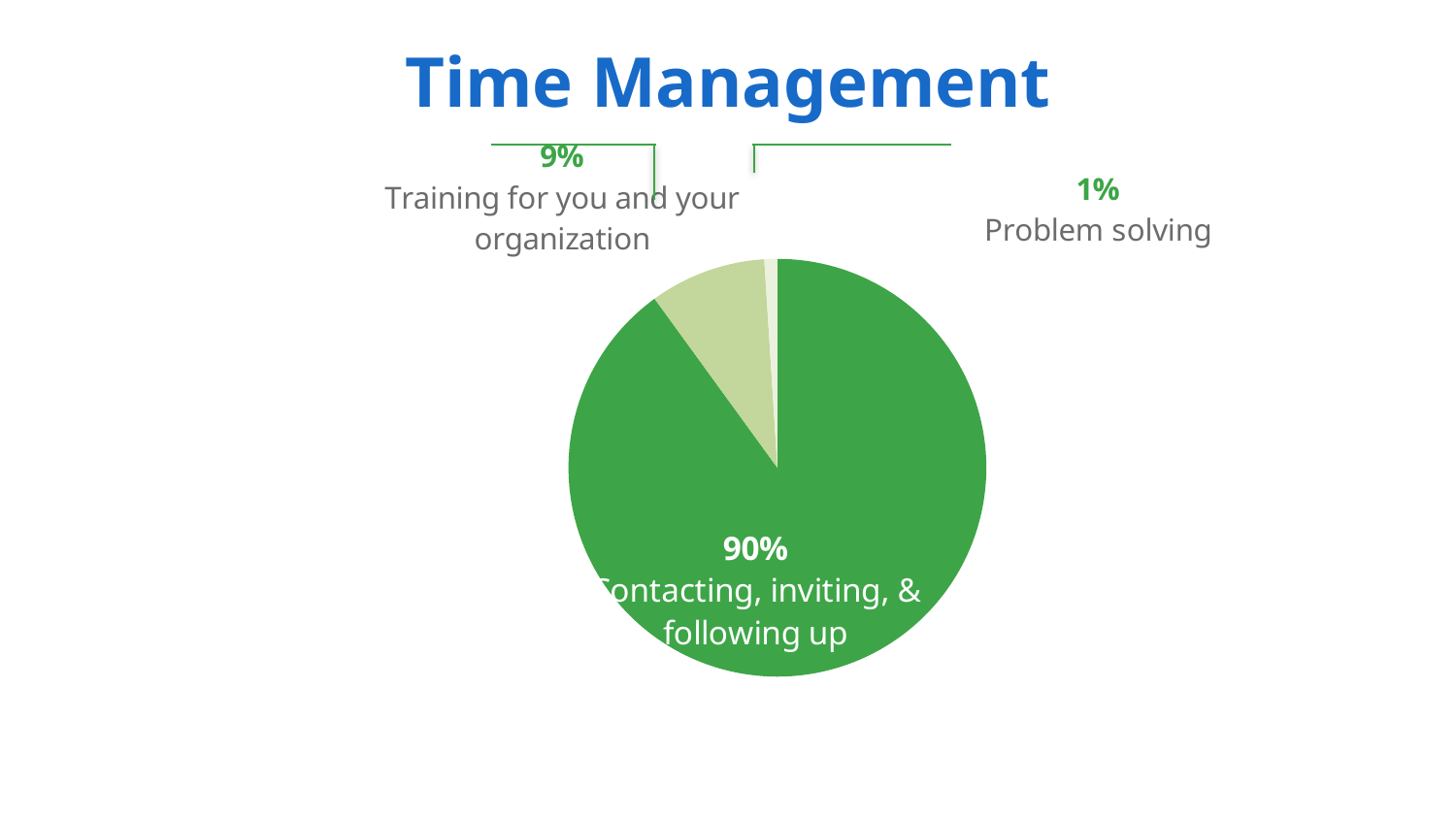
What share of the pie is labelled "Problem solving"? 1% What share of the pie is labelled "Training for you and your organization"? 9% What is the difference in percentage points between "Contacting, inviting, & following up" and "Training for you and your organization"? 81 What is the title of the chart? Time Management How many slices does the pie chart have? 3 What share of the pie is labelled "Contacting, inviting, & following up"? 90% Which category has the largest slice of the pie? Contacting, inviting, & following up What kind of chart is shown on the slide? pie chart What is the difference in percentage points between "Training for you and your organization" and "Problem solving"? 8 What colour is the largest slice of the pie? green Which is larger, the slice for "Training for you and your organization" or the slice for "Problem solving"? Training for you and your organization Which category has the smallest slice of the pie? Problem solving